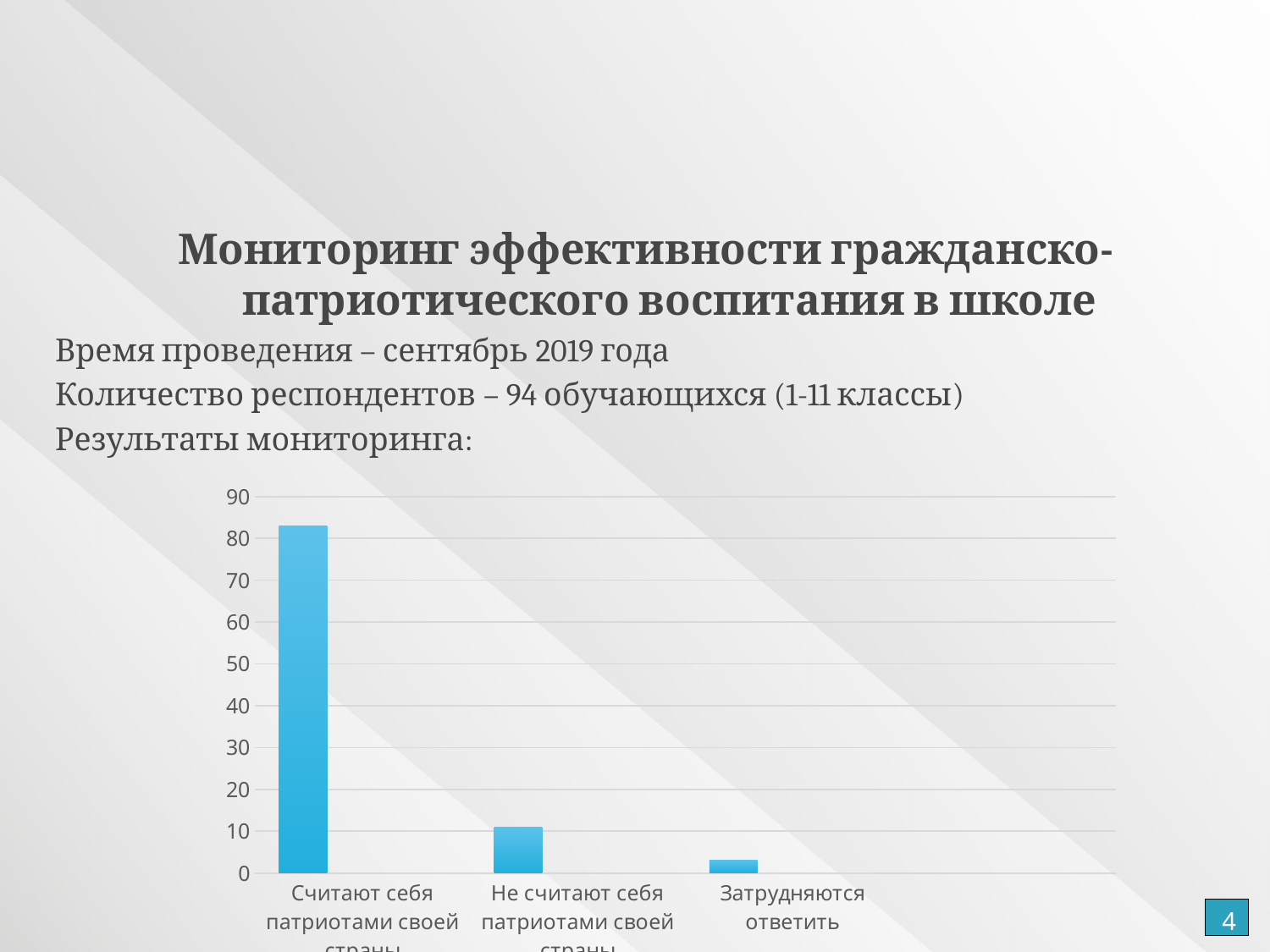
Is the value for "Считают себя патриотами своей страны" greater or less than 80? greater Which is larger: the value for "Не считают себя патриотами своей страны" or the value for "Затрудняются ответить"? Не считают себя патриотами своей страны How many categories are shown on the x axis of the chart? 3 Is the value for "Не считают себя патриотами своей страны" greater or less than 20? less Is the value for "Затрудняются ответить" greater or less than 10? less Which category has the lowest bar in the chart? Затрудняются ответить What kind of chart is shown on the slide? bar chart What is the highest tick value shown on the vertical axis of the chart? 90 Which category has the highest bar in the chart? Считают себя патриотами своей страны Do the bar values rise or fall from left to right along the x axis? fall